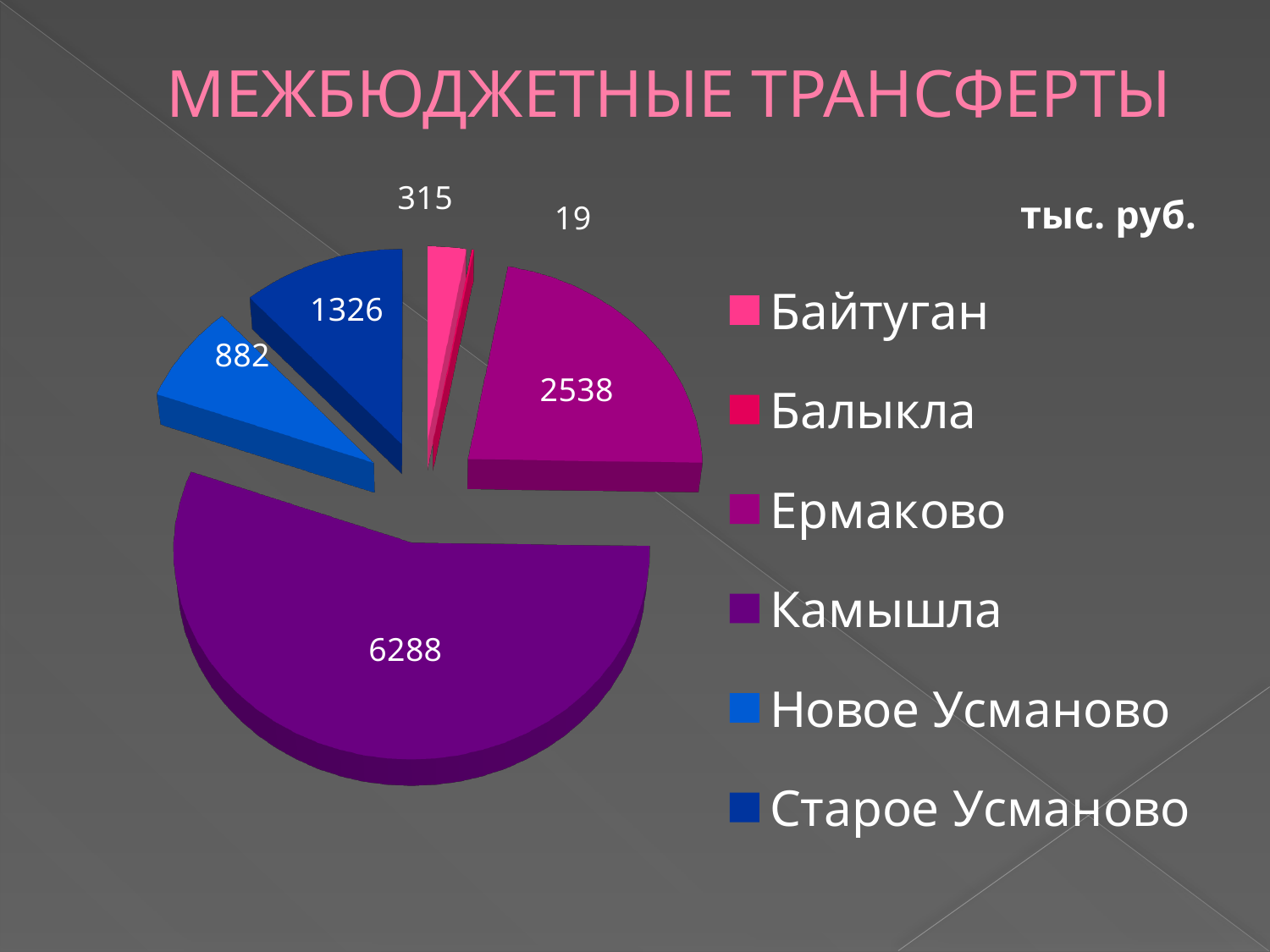
What is the value for Новое Усманово? 882 What is the difference between the values for Камышла and Ермаково? 3750 What is the value for Камышла? 6288 Which category has the smallest slice of the pie? Балыкла Which is larger, the value for Старое Усманово or the value for Новое Усманово? Старое Усманово What unit is stated for the values on the chart? тыс. руб. What type of chart is shown on the slide? pie chart What is the value for Ермаково? 2538 Which category has the largest slice of the pie? Камышла What is the value for Балыкла? 19 What is the value for Старое Усманово? 1326 How many categories does the legend list? 6